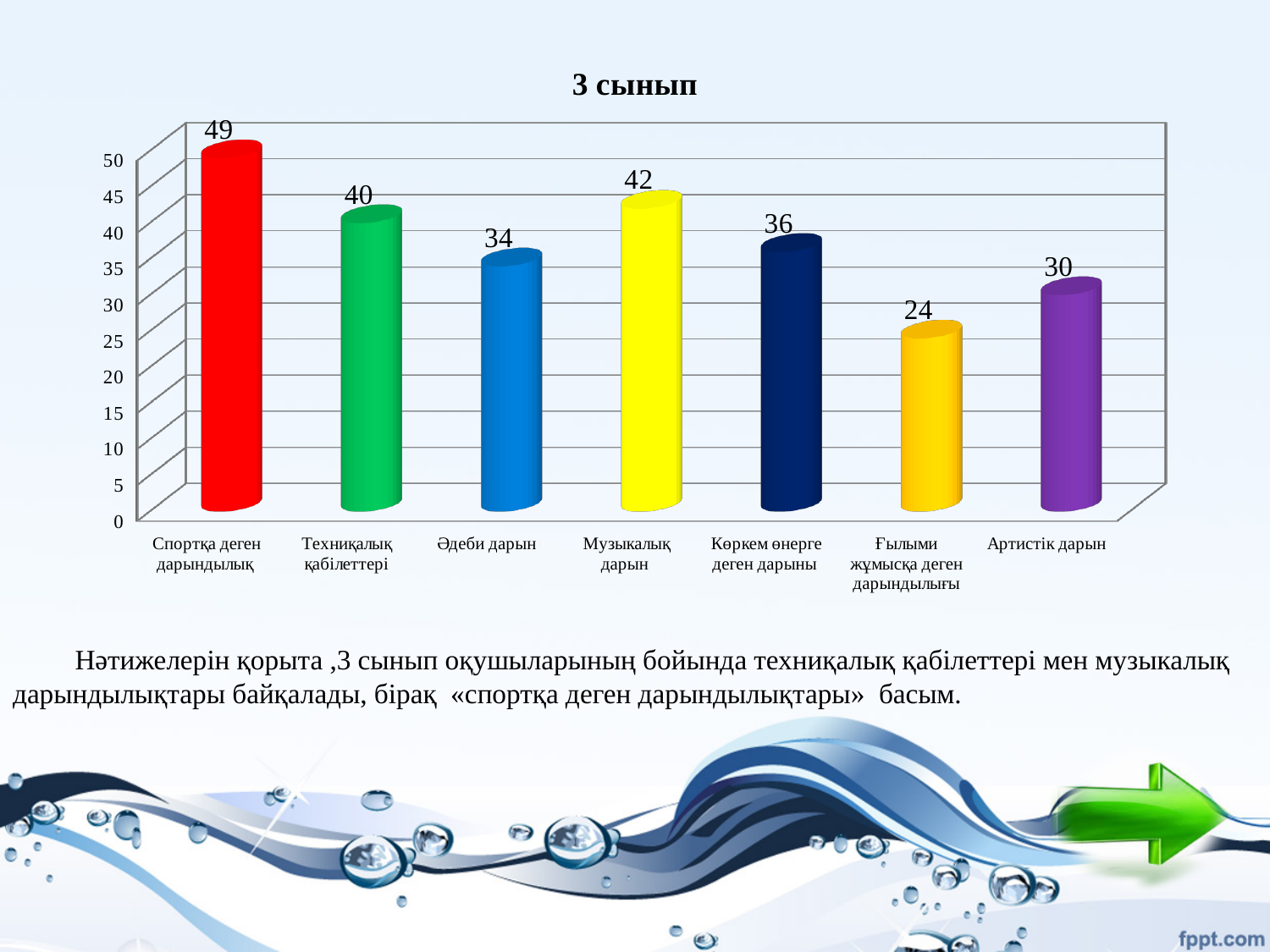
Which is larger, the value for Көркем өнерге деген дарыны or the value for Артистік дарын? Көркем өнерге деген дарыны Which category has the lowest value? Ғылыми жұмысқа деген дарындылығы What is the value for Музыкалық дарын? 42 What is the value for Спортқа деген дарындылық? 49 What colour is the bar for Музыкалық дарын? yellow What is the difference between the values for Техникалық қабілеттері and Әдеби дарын? 6 How many categories are shown on the chart? 7 Is the value for Артистік дарын greater or less than 35? less Which category has the highest value? Спортқа деген дарындылық What kind of chart is shown on the slide? bar chart What is the title of the chart? 3 сынып What is the value for Ғылыми жұмысқа деген дарындылығы? 24